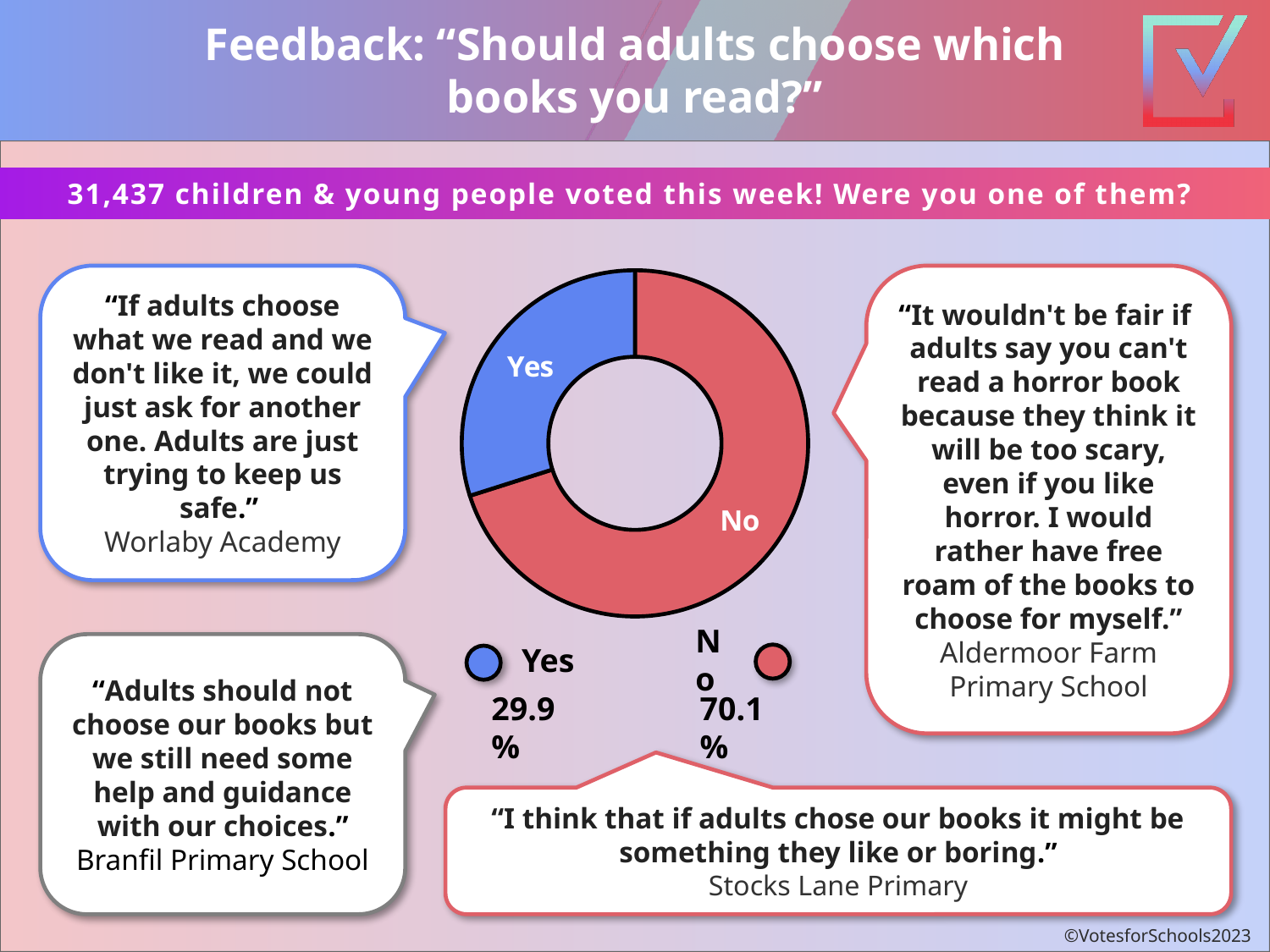
Which response received the smaller share of votes? Yes How many categories are shown in the donut chart? 2 Which response received the larger share of votes, Yes or No? No Is the share for Yes larger or smaller than the share for No? smaller What colour represents the "No" segment in the chart? Red What percentage of votes did "Yes" receive in the donut chart? 29.9% What colour represents the "Yes" segment in the chart? Blue What percentage of votes did "No" receive in the donut chart? 70.1% What type of chart is used to show the vote results? Donut (pie) chart What is the difference in percentage points between the No and Yes shares? 40.2 What is the combined total of the Yes and No percentages shown? 100% Is the share for No greater or less than 50%? greater